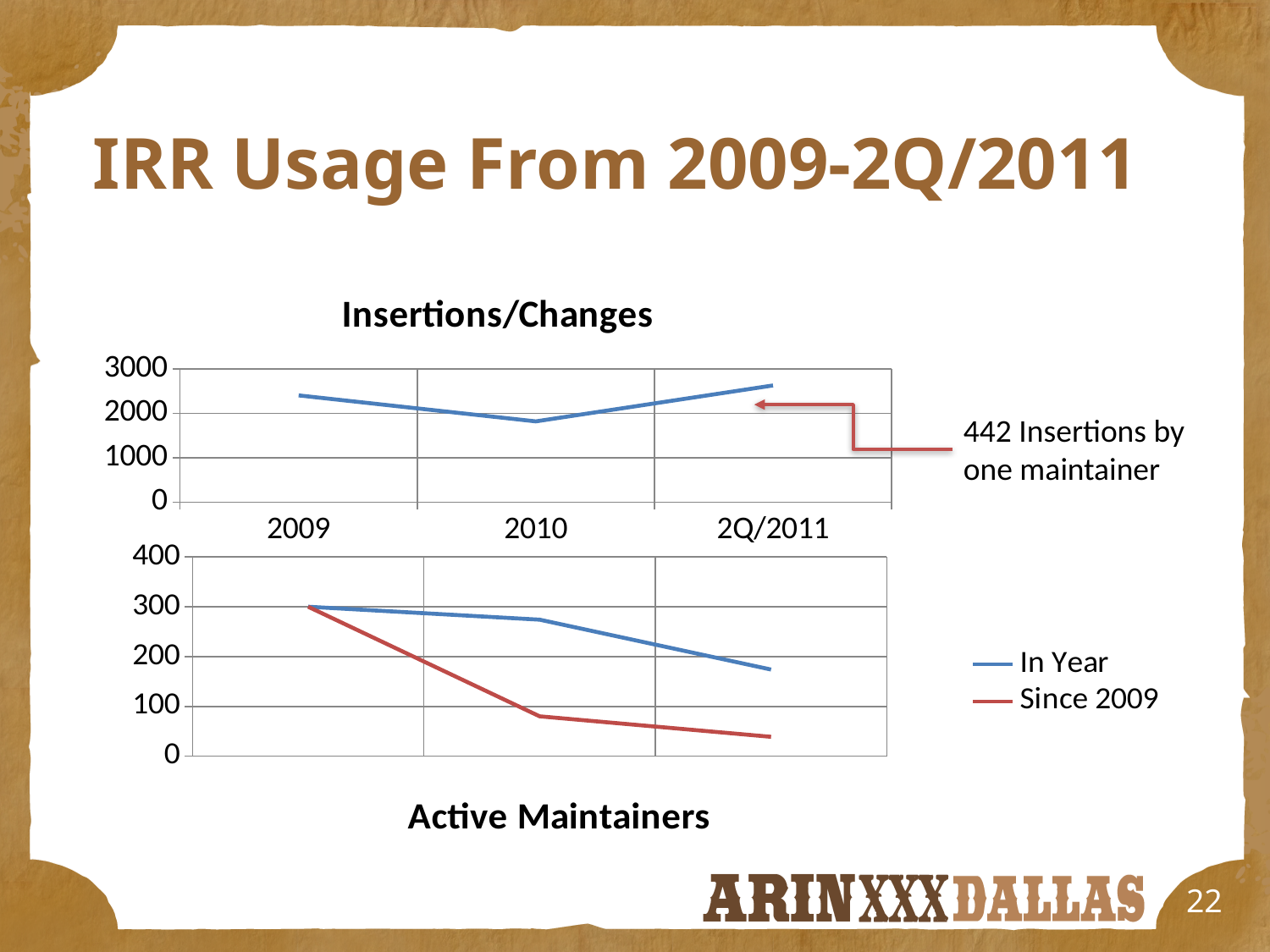
On the Active Maintainers chart, is the In Year value for 2Q/2011 greater or less than 200? less How many points are plotted on the Insertions/Changes chart? 3 On the Insertions/Changes chart, is the value for 2010 greater or less than 2000? less On the Insertions/Changes chart, is the value for 2009 greater or less than 2000? greater How many series does the legend of the Active Maintainers chart list? 2 On the Active Maintainers chart, which series has the larger value in 2010, In Year or Since 2009? In Year On the Insertions/Changes chart, which year has the lowest value? 2010 What does the annotation next to the Insertions/Changes chart say? 442 Insertions by one maintainer On the Active Maintainers chart, does the Since 2009 series rise or fall from 2009 to 2Q/2011? fall What kind of chart is the Insertions/Changes chart? line chart On the Insertions/Changes chart, which is larger, the value for 2010 or the value for 2Q/2011? 2Q/2011